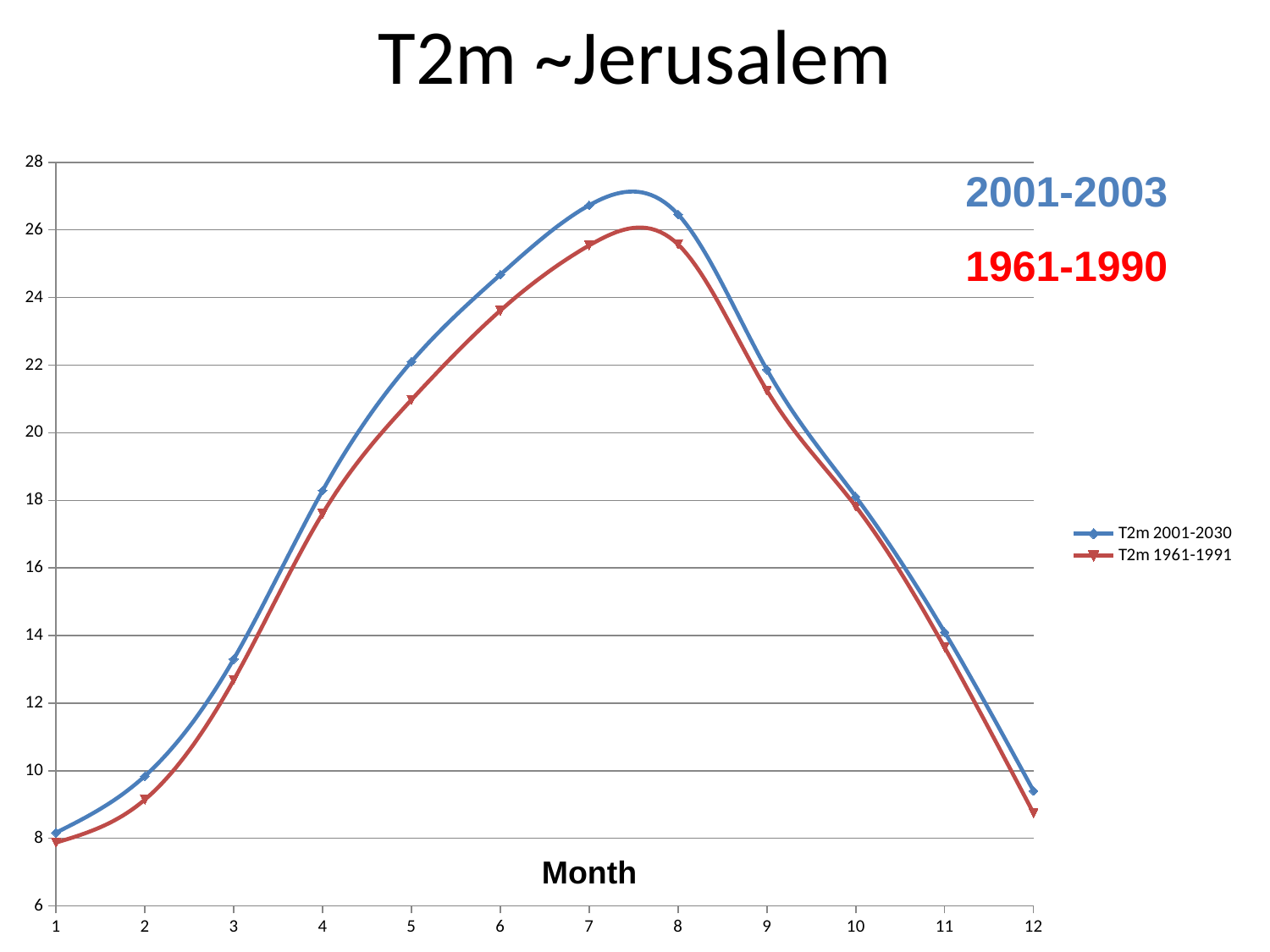
Is the value for T2m 2001-2030 in month 7 greater or less than 26? greater Is the value for T2m 2001-2030 in month 12 greater or less than 10? less Do the values of the T2m 2001-2030 series rise or fall from month 1 to month 7? rise What kind of chart is shown on the slide? line chart What are the two legend entries? T2m 2001-2030 and T2m 1961-1991 In which month is the T2m 1961-1991 series at its lowest? 1 Which series has the higher value in month 6, T2m 2001-2030 or T2m 1961-1991? T2m 2001-2030 How many series does the legend list? 2 Is the value for T2m 1961-1991 in month 5 greater or less than 20? greater In which month is the T2m 2001-2030 series at its lowest? 1 How many months are plotted along the x axis? 12 What is the title of the chart? T2m ~Jerusalem